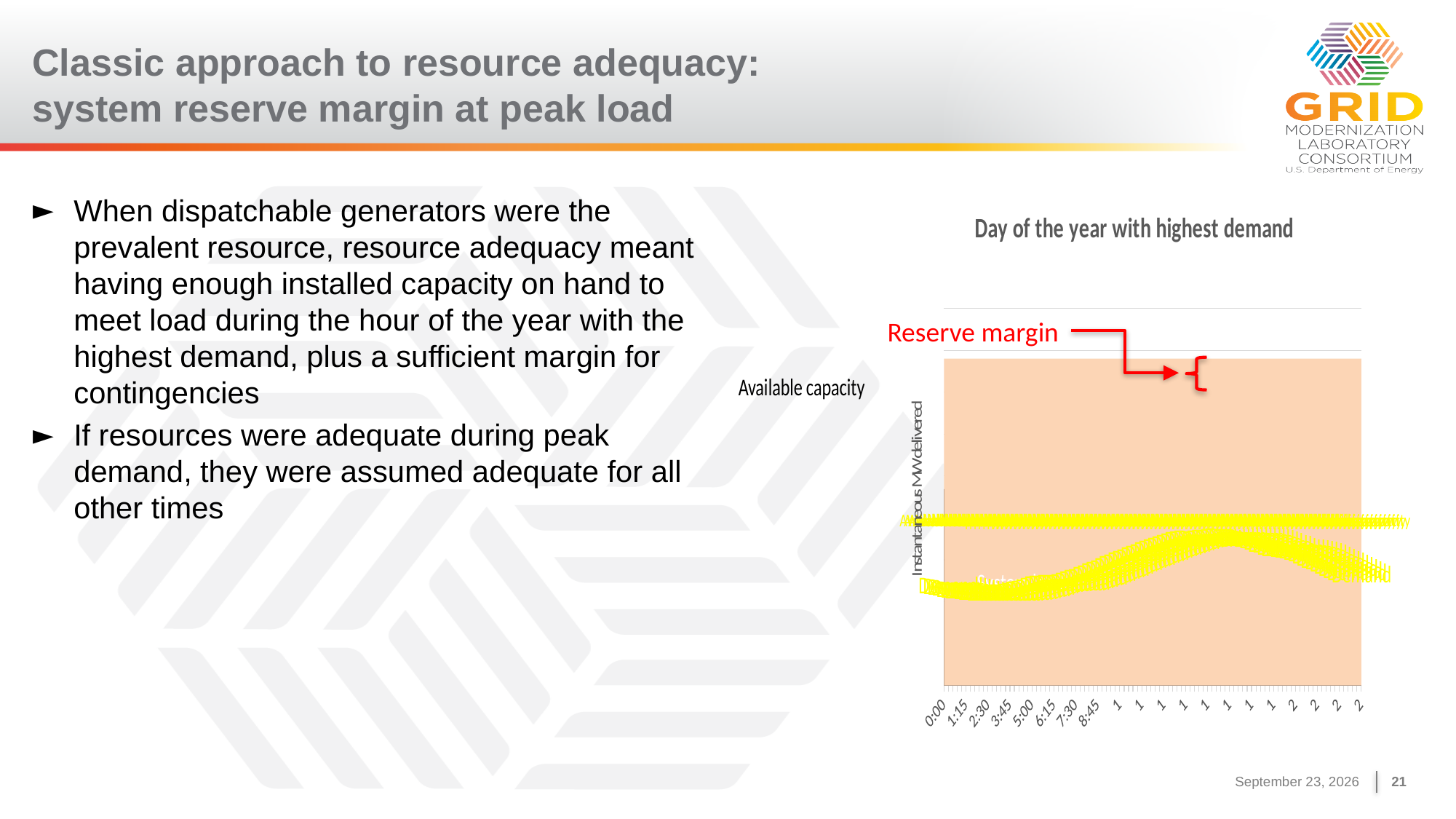
What is the label on the vertical axis of the chart? Instantaneous MW delivered Does the system load line rise or fall between 8:45 and the middle of the day? rise Does the available capacity line rise, fall, or stay flat across the day? stay flat What kind of chart is shown on the slide? area chart Does the system load line rise or fall after its midday peak toward the end of the day? fall What is the title of the chart on the slide? Day of the year with highest demand How many lines are plotted on the chart? 2 What is the first time label on the horizontal axis of the chart? 0:00 Which line is higher on the chart, the available capacity line or the system load line? available capacity